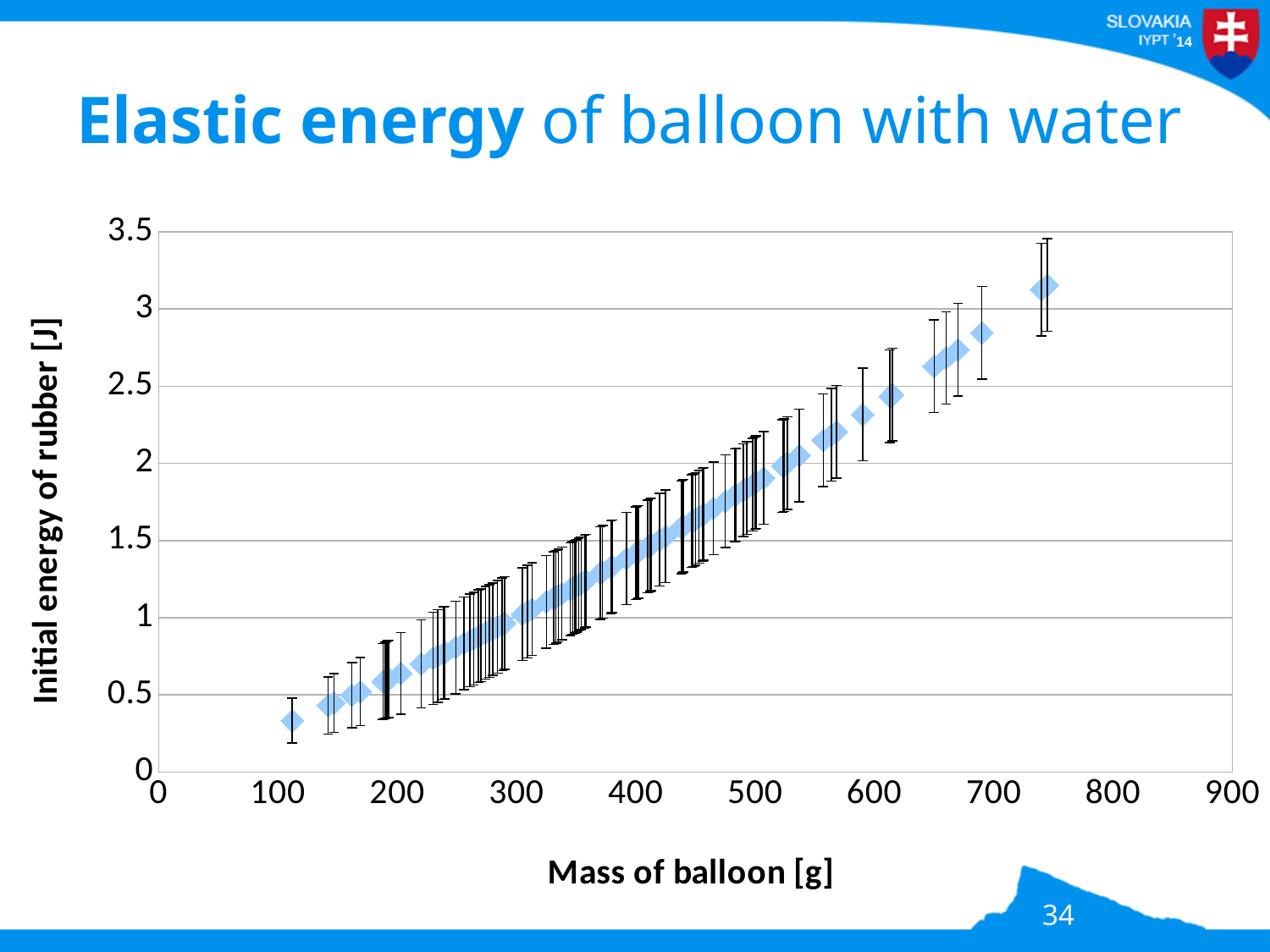
What is the label of the y axis? Initial energy of rubber [J] Is the initial energy of rubber for the balloon of about 690 g greater or less than 2.5 J? greater What is the label of the x axis? Mass of balloon [g] Is the initial energy of rubber for the balloon with the largest mass (about 750 g) greater or less than 3 J? greater What kind of chart is shown on the slide? scatter chart Is the initial energy of rubber for the balloon of about 590 g greater or less than 2 J? greater Does the point with the highest initial energy of rubber correspond to the largest or the smallest mass of balloon? largest Which has the higher initial energy of rubber: the balloon of about 500 g or the balloon of about 200 g? the balloon of about 500 g Do the values of initial energy of rubber rise or fall as the mass of balloon increases? rise